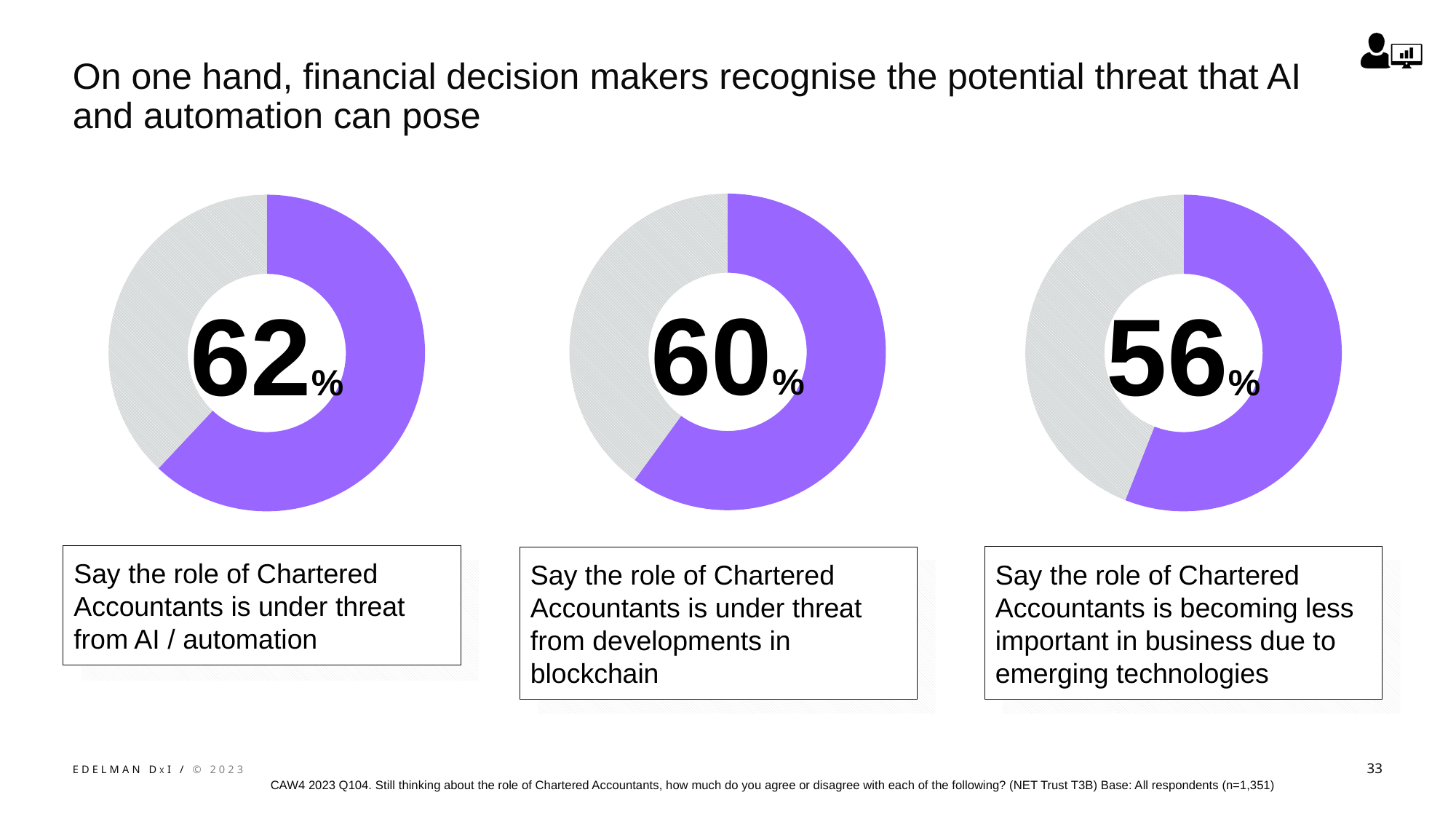
Which statement has the lowest percentage of agreement? Say the role of Chartered Accountants is becoming less important in business due to emerging technologies What percentage say the role of Chartered Accountants is under threat from developments in blockchain? 60% What percentage say the role of Chartered Accountants is under threat from AI / automation? 62% Which is larger: the percentage for the blockchain threat or the percentage for emerging technologies making the role less important? Blockchain threat (60%) What type of chart is used to display the percentages on this slide? Donut chart Which statement has the highest percentage of agreement? Say the role of Chartered Accountants is under threat from AI / automation What colour is used for the highlighted (agreeing) portion of each donut chart? Purple What is the difference in percentage points between the AI / automation threat chart and the emerging technologies chart? 6 Do the percentages rise or fall moving from the left chart to the right chart? Fall What is the difference in percentage points between the AI / automation threat chart and the blockchain threat chart? 2 How many donut charts are shown on the slide? 3 What percentage say the role of Chartered Accountants is becoming less important in business due to emerging technologies? 56%